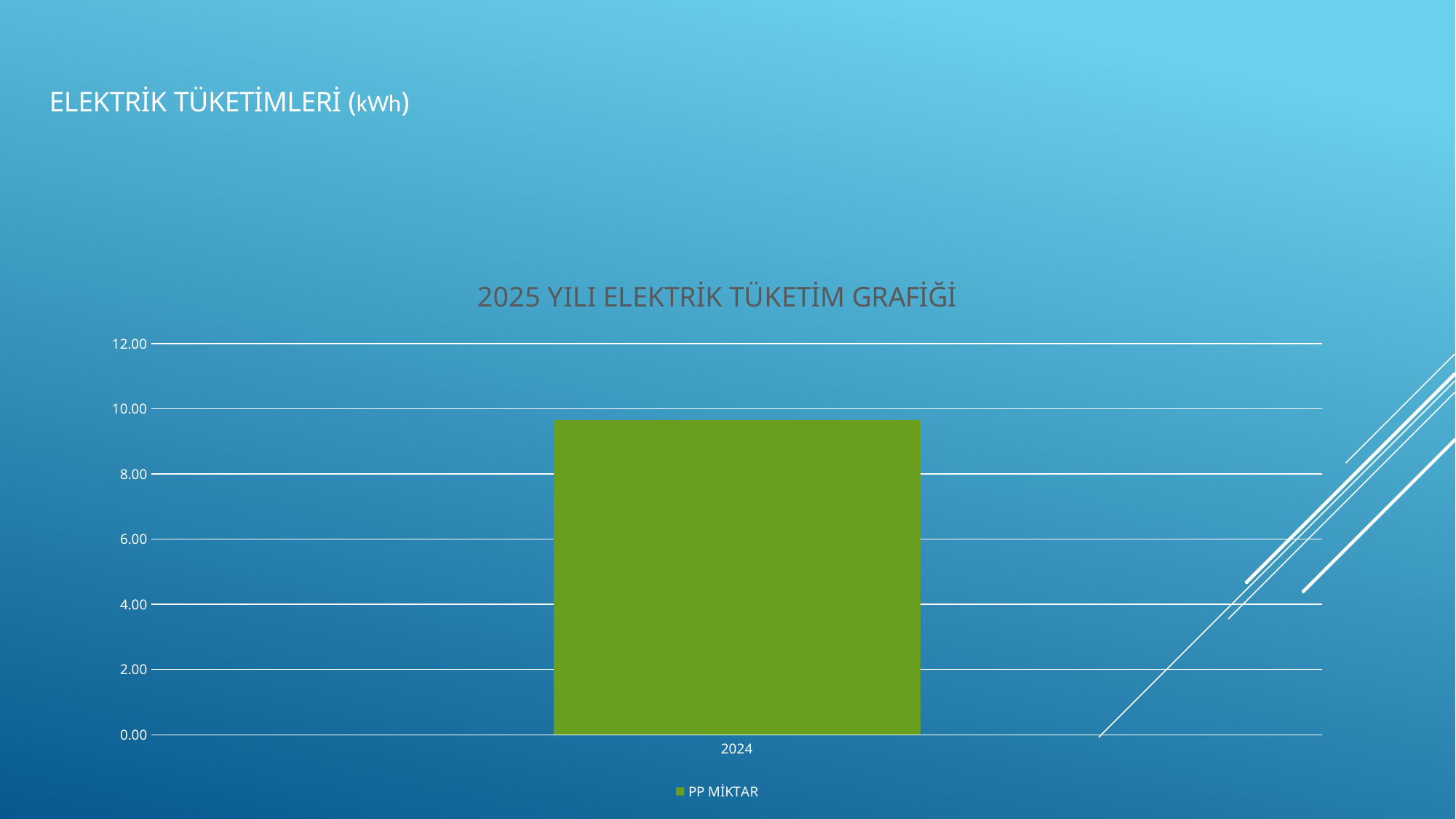
What is the highest value shown on the chart's y axis? 12.00 How many bars are plotted in the chart? 1 What kind of chart is shown on the slide? bar chart What series name is shown in the chart legend? PP MİKTAR What category label appears on the x axis of the chart? 2024 How many series does the legend list? 1 Is the value for 2024 greater or less than 10.00? less Is the value for 2024 greater or less than 6.00? greater Is the value for 2024 greater or less than 8.00? greater What is the title of the chart? 2025 YILI ELEKTRİK TÜKETİM GRAFİĞİ